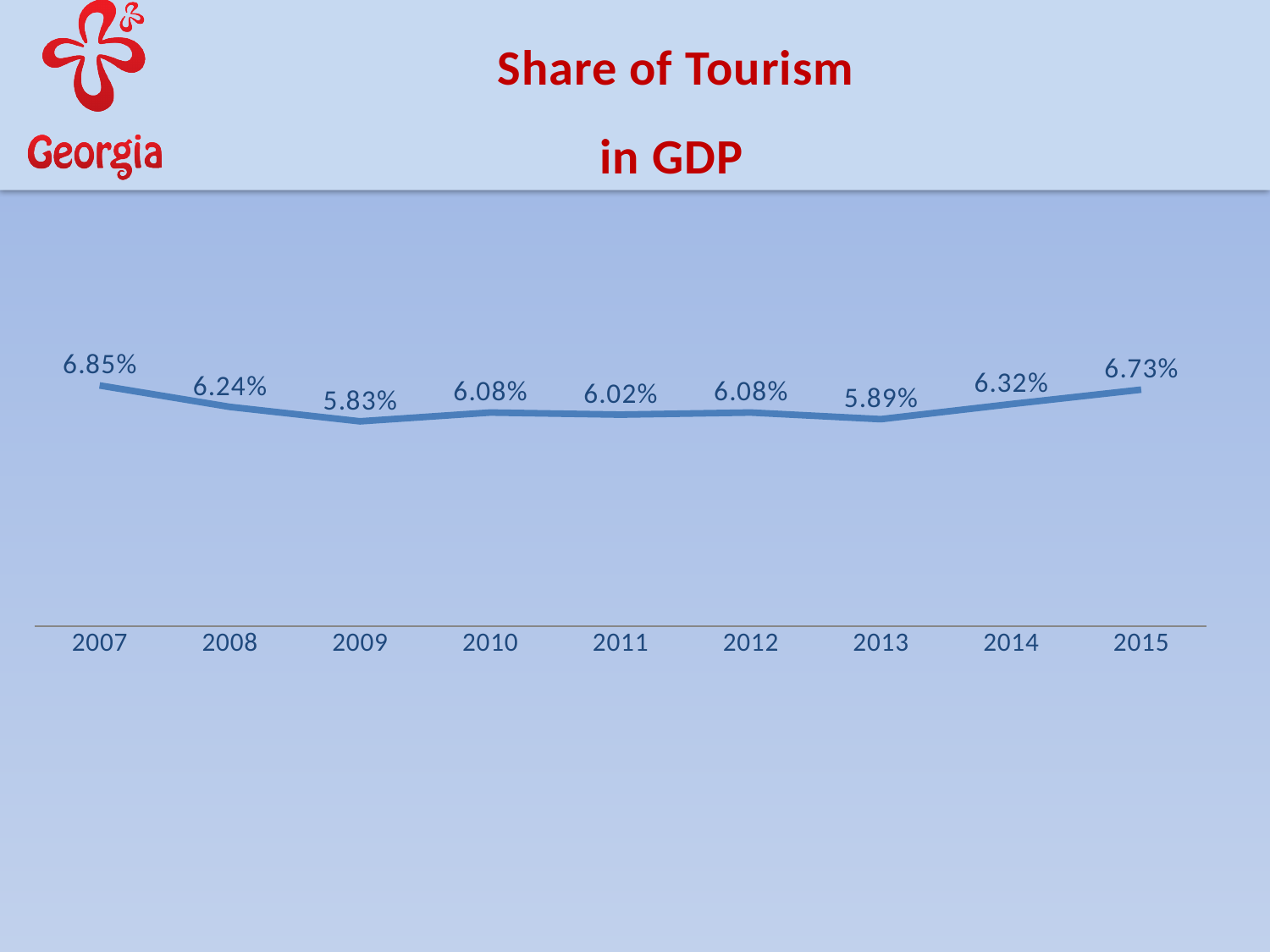
How many years are shown on the x axis of the chart? 9 What was the share of tourism in GDP in 2007? 6.85% What kind of chart is shown on the slide? Line chart Which year had the lowest share of tourism in GDP? 2009 Which year had the highest share of tourism in GDP? 2007 What was the share of tourism in GDP in 2009? 5.83% What was the share of tourism in GDP in 2014? 6.32% What is the difference between the share of tourism in GDP in 2015 and in 2014? 0.41% What was the share of tourism in GDP in 2015? 6.73% What is the difference between the share of tourism in GDP in 2007 and in 2009? 1.02% Which year had a larger share of tourism in GDP, 2008 or 2013? 2008 Did the share of tourism in GDP rise or fall from 2013 to 2015? Rise